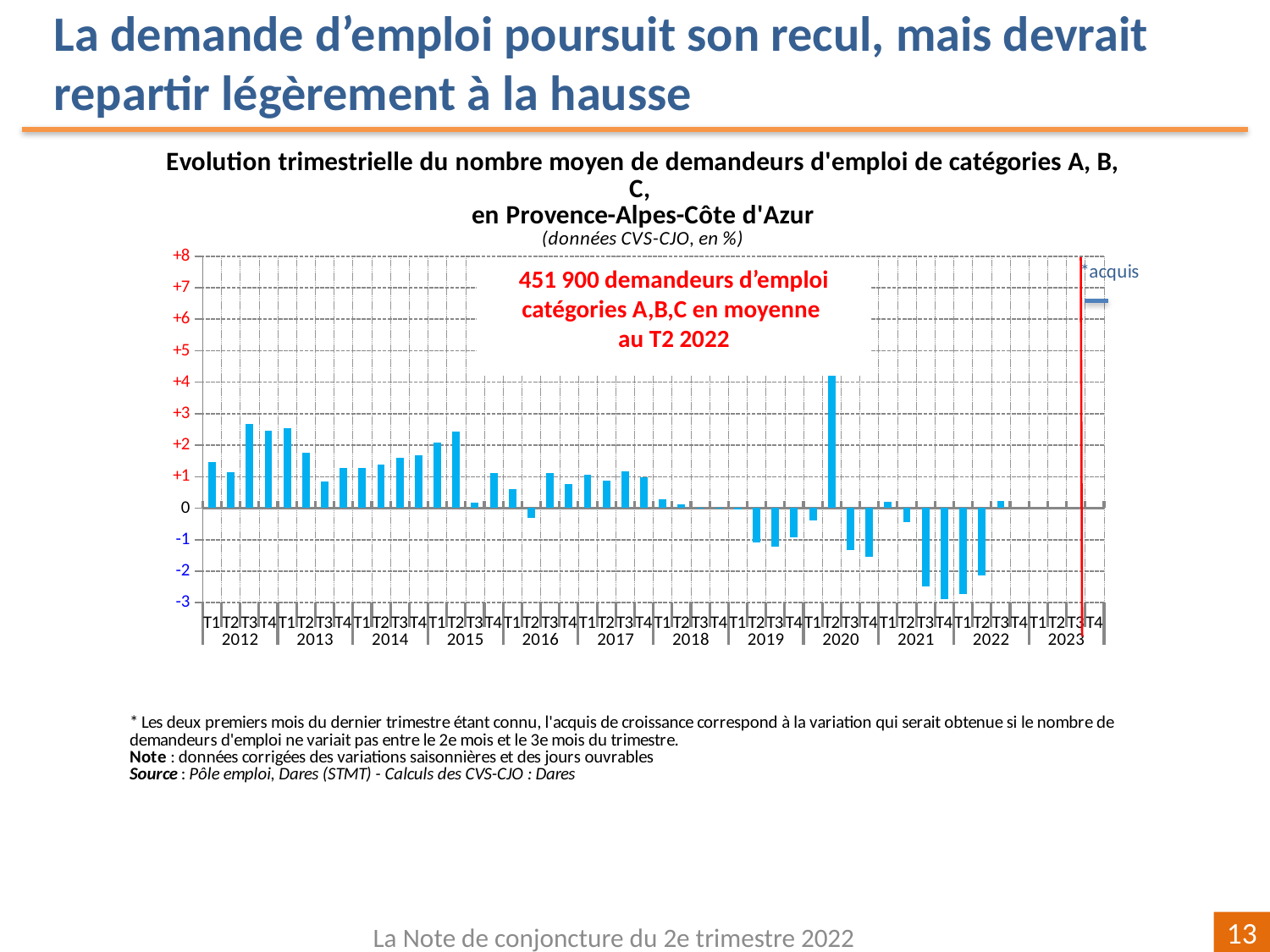
Is the value for T2 2020 greater or less than +3? greater Which is larger, the value for T1 2012 or the value for T2 2012? T1 2012 How many years are labelled on the x axis of the chart? 12 According to the red text on the chart, how many demandeurs d'emploi catégories A,B,C were there on average in T2 2022? 451 900 What kind of chart is shown on the slide? bar chart Which quarter has the highest value in the chart? T2 2020 Is the value for T2 2012 greater or less than +2? less Is the value for T1 2022 greater or less than -2? less In what unit are the data in the chart expressed, according to the subtitle? en % Which is larger, the value for T2 2020 or the value for T2 2012? T2 2020 Do the values rise or fall from T1 2021 to T4 2021? fall